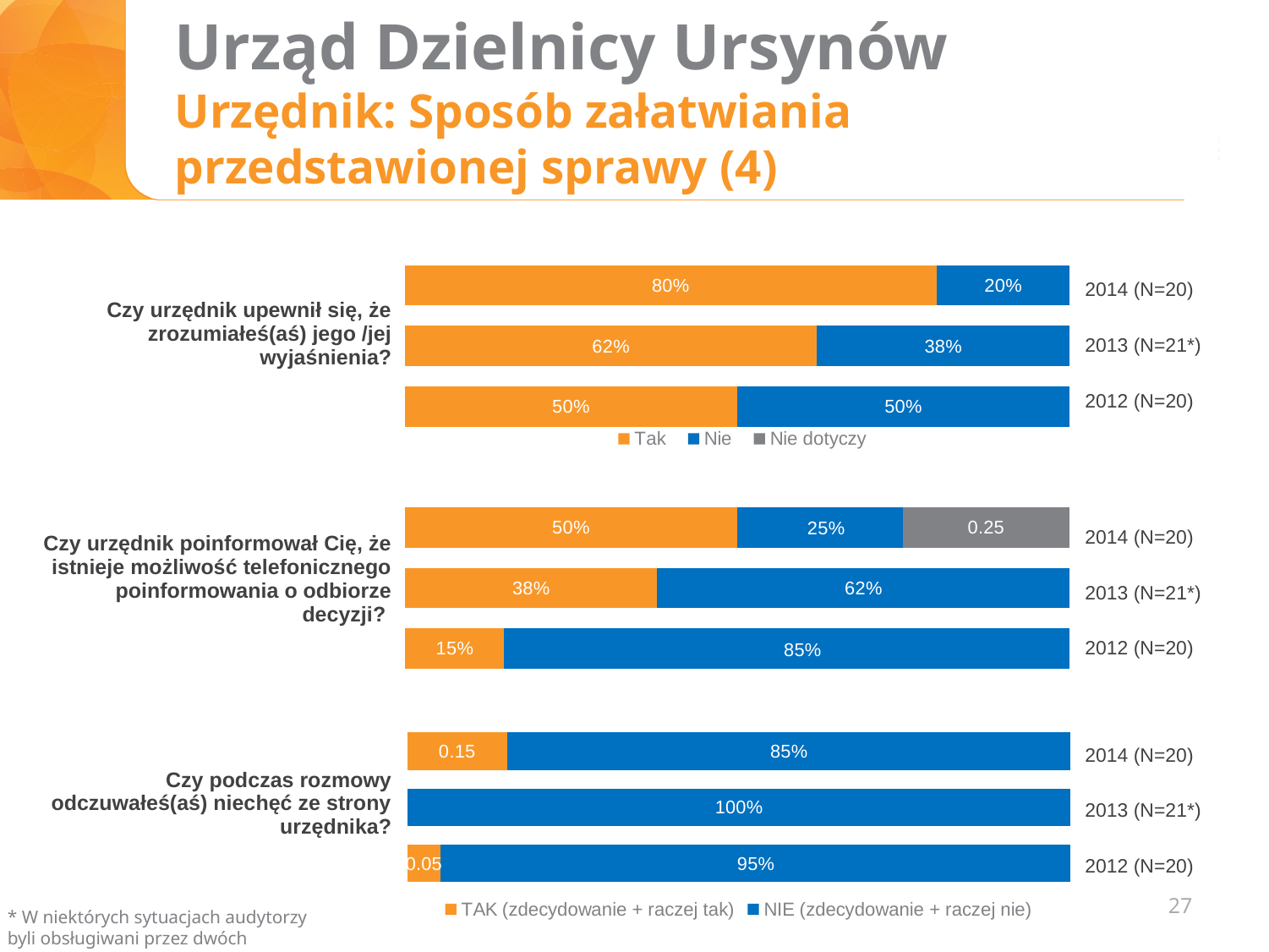
In the chart for "Czy urzędnik poinformował Cię, że istnieje możliwość telefonicznego poinformowania o odbiorze decyzji?", what is the difference between the "Tak" values for 2014 (N=20) and 2013 (N=21*)? 12% In the chart for "Czy urzędnik upewnił się, że zrozumiałeś(aś) jego /jej wyjaśnienia?", how many entries does the legend list? 3 In the chart for "Czy urzędnik poinformował Cię, że istnieje możliwość telefonicznego poinformowania o odbiorze decyzji?", which year has the lowest "Tak" value? 2012 (N=20) What kind of chart is used for "Czy podczas rozmowy odczuwałeś(aś) niechęć ze strony urzędnika?"? Stacked bar chart In the chart for "Czy podczas rozmowy odczuwałeś(aś) niechęć ze strony urzędnika?", what is the "NIE" value for 2013 (N=21*)? 100% In the chart for "Czy podczas rozmowy odczuwałeś(aś) niechęć ze strony urzędnika?", what is the "TAK" value for 2014 (N=20)? 0.15 In the chart for "Czy urzędnik poinformował Cię, że istnieje możliwość telefonicznego poinformowania o odbiorze decyzji?", what is the "Nie" value for 2012 (N=20)? 85% In the chart for "Czy urzędnik upewnił się, że zrozumiałeś(aś) jego /jej wyjaśnienia?", what is the "Nie" value for 2013 (N=21*)? 38% In the chart for "Czy urzędnik poinformował Cię, że istnieje możliwość telefonicznego poinformowania o odbiorze decyzji?", what is the "Nie dotyczy" value for 2014 (N=20)? 0.25 In the chart for "Czy urzędnik upewnił się, że zrozumiałeś(aś) jego /jej wyjaśnienia?", what is the "Tak" value for 2014 (N=20)? 80% In the chart for "Czy urzędnik upewnił się, że zrozumiałeś(aś) jego /jej wyjaśnienia?", which year has the highest "Tak" value? 2014 (N=20) In the chart for "Czy podczas rozmowy odczuwałeś(aś) niechęć ze strony urzędnika?", which is larger: the "NIE" value for 2014 (N=20) or for 2012 (N=20)? 2012 (N=20)